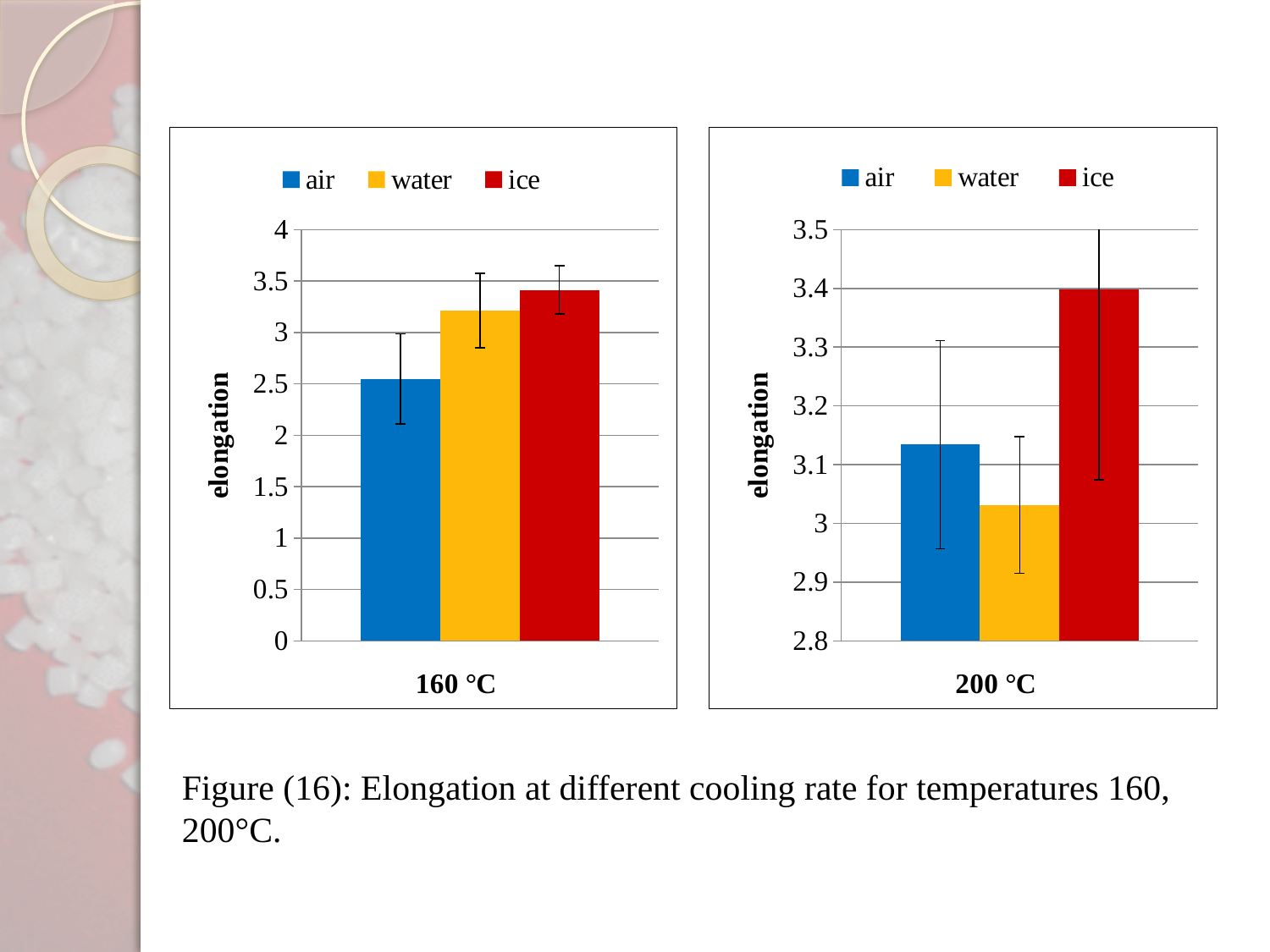
In the 200 °C chart, which cooling medium has the highest elongation? ice In the 160 °C chart, is the elongation for air greater or less than 3? less How many bars are plotted in the 160 °C chart? 3 What kind of chart is the 160 °C chart on the left? bar chart How many series does the legend of the 200 °C chart list? 3 In the 160 °C chart, is the elongation for water greater or less than 3? greater What is the y-axis title of the 200 °C chart? elongation In the 200 °C chart, is the elongation for ice greater or less than 3.3? greater In the 160 °C chart, which cooling medium has the lowest elongation? air In the 200 °C chart, which has the larger elongation, air or water? air In the 160 °C chart, which cooling medium has the highest elongation? ice In the 200 °C chart, which cooling medium has the lowest elongation? water